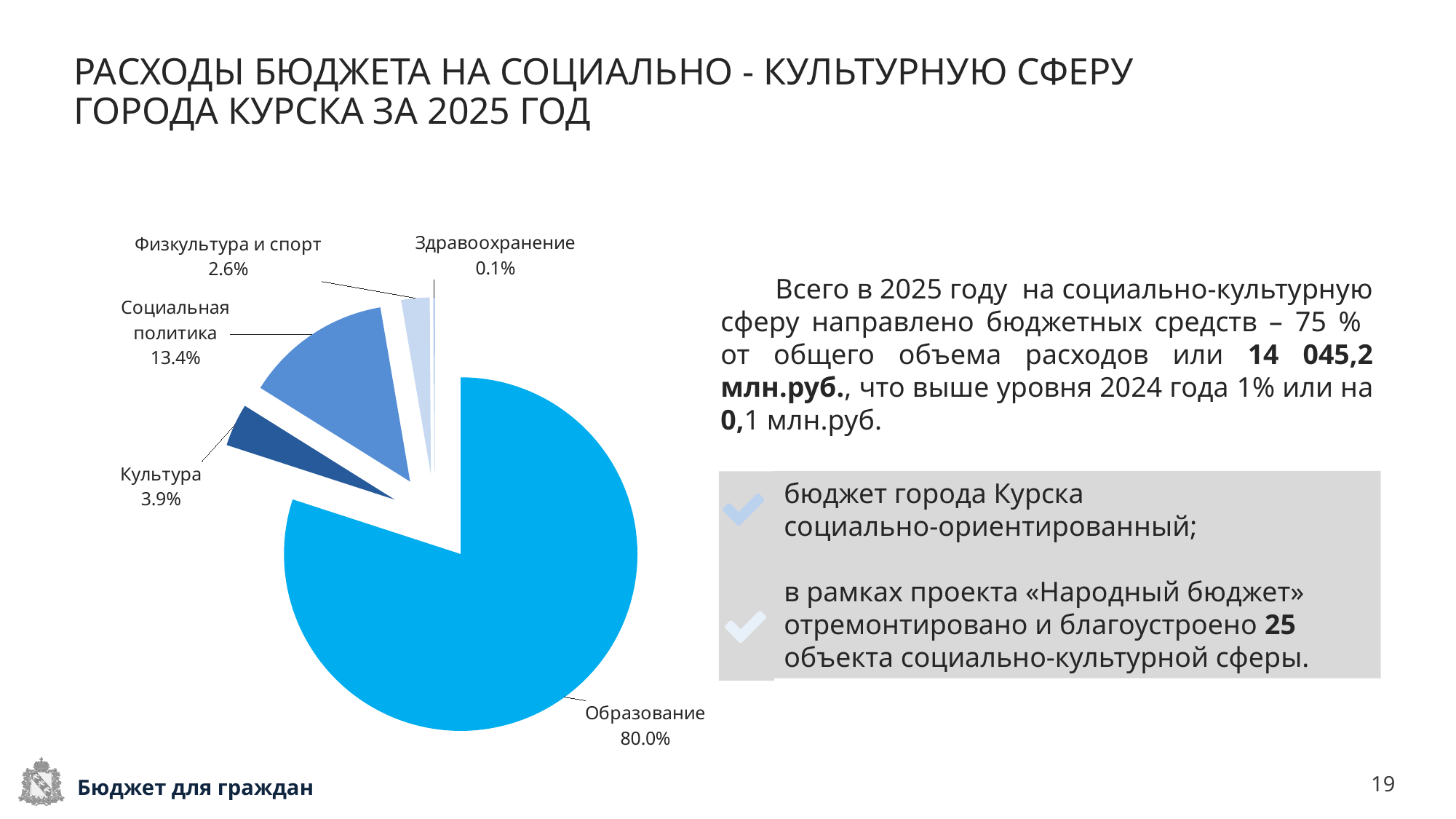
Which is larger, the share for Культура or the share for Физкультура и спорт? Культура What is the value shown for Социальная политика? 13.4% What is the difference between the shares of Социальная политика and Культура? 9.5% What is the value shown for Физкультура и спорт? 2.6% What is the value shown for Культура? 3.9% Which category has the smallest share of the pie? Здравоохранение What is the value shown for Здравоохранение? 0.1% Which category has the largest share of the pie? Образование What kind of chart is shown on the slide? Pie chart What share of the pie does Образование have? 80.0% How many slices does the pie chart have? 5